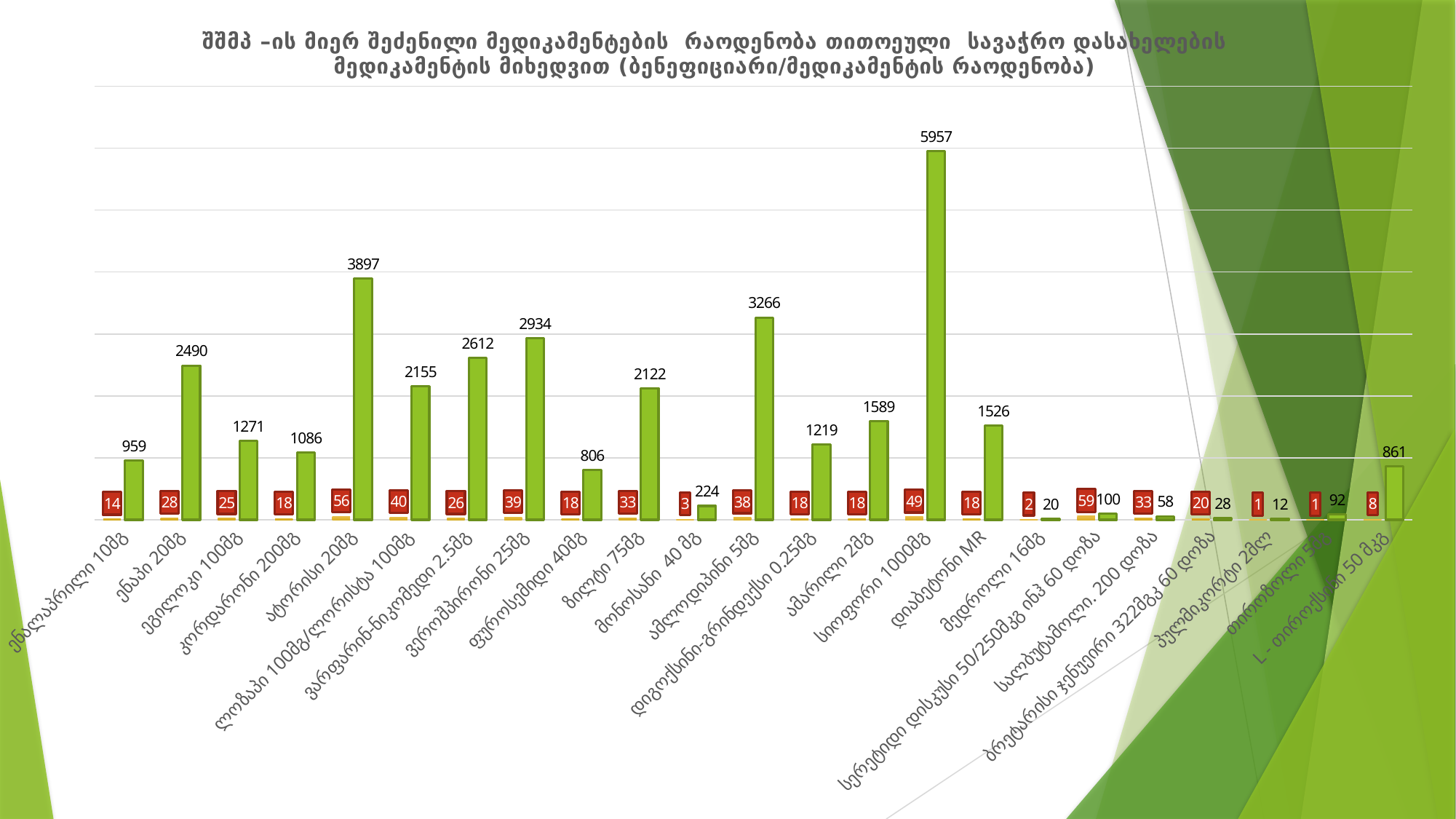
What kind of chart is shown on the slide? Bar chart What is the medication quantity value shown for ატორისი 20მგ? 3897 Which has a larger medication quantity, ამლოდიპინი 5მგ or ვარფარინ-ნიკომედი 2.5მგ? ამლოდიპინი 5მგ What colour are the bars showing medication quantity? Green What is the difference between the medication quantity for ენაპ 20მგ and ენალაპრილი 10მგ? 1531 What is the difference between the medication quantity for სიოფორი 1000მგ and ატორისი 20მგ? 2060 What is the medication quantity value shown for L - თიროქსინი 50 მკგ? 861 What is the red beneficiary label value shown for სიოფორი 1000მგ? 49 How many medication categories are shown on the x axis? 23 Which category has the lowest medication quantity? პულმიკორტი 2მლ What is the medication quantity value shown for ვეროშპირონი 25მგ? 2934 Which category has the highest medication quantity? სიოფორი 1000მგ